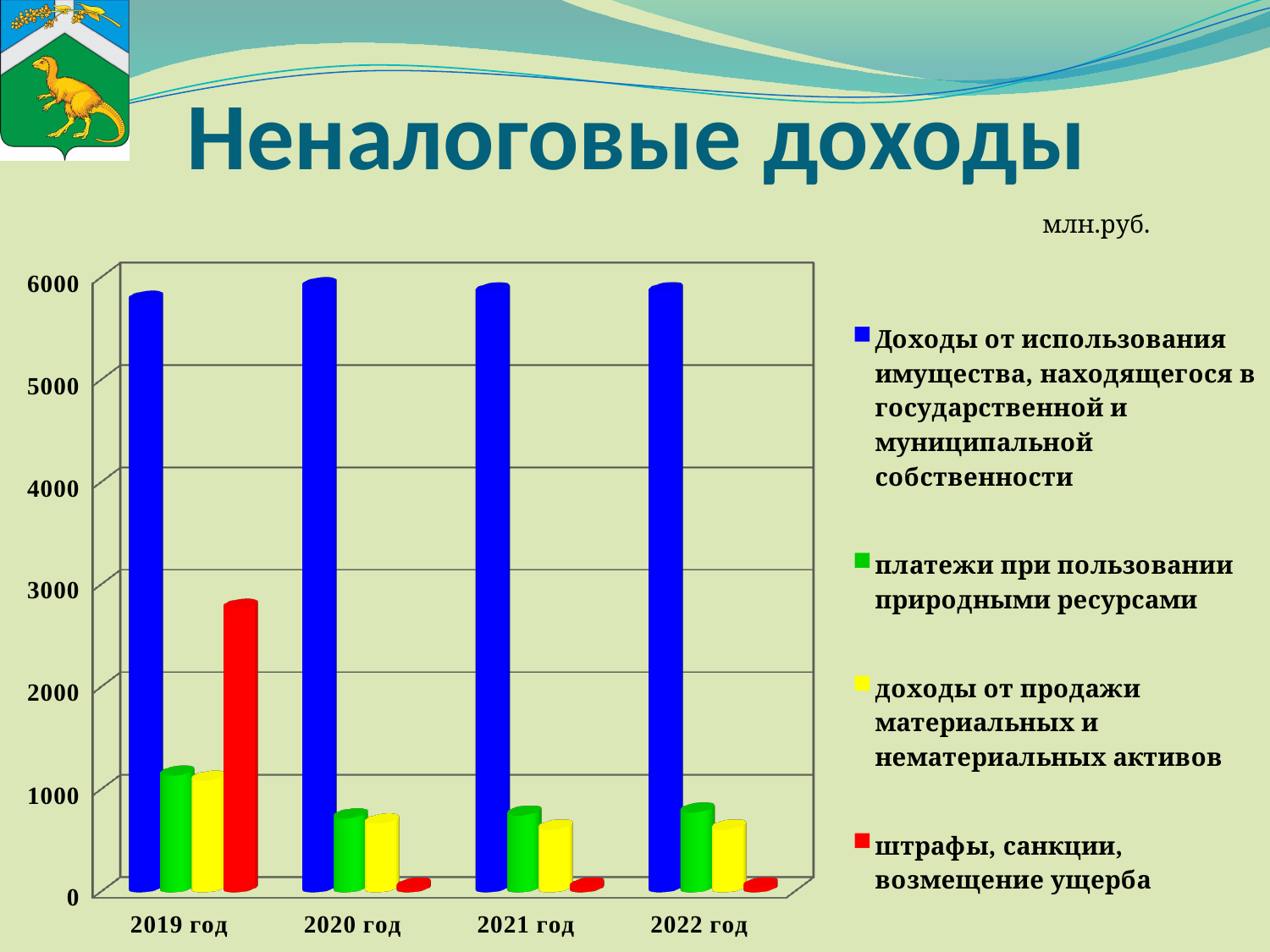
In 2019 год, which is larger: 'штрафы, санкции, возмещение ущерба' or 'платежи при пользовании природными ресурсами'? штрафы, санкции, возмещение ущерба Is the value for 'платежи при пользовании природными ресурсами' in 2021 год greater or less than 1000? less How many years (categories) are shown on the x axis of the chart? 4 In which year is the value for 'штрафы, санкции, возмещение ущерба' the highest? 2019 год How many series does the chart legend list? 4 Which series has the lowest value in 2022 год? штрафы, санкции, возмещение ущерба What is the title of the chart on the slide? Неналоговые доходы Is the value for 'штрафы, санкции, возмещение ущерба' in 2019 год greater or less than 2000? greater Is the value for 'штрафы, санкции, возмещение ущерба' in 2020 год greater or less than 1000? less What kind of chart is shown on the slide? bar chart Does the value for 'штрафы, санкции, возмещение ущерба' rise or fall from 2019 год to 2020 год? fall